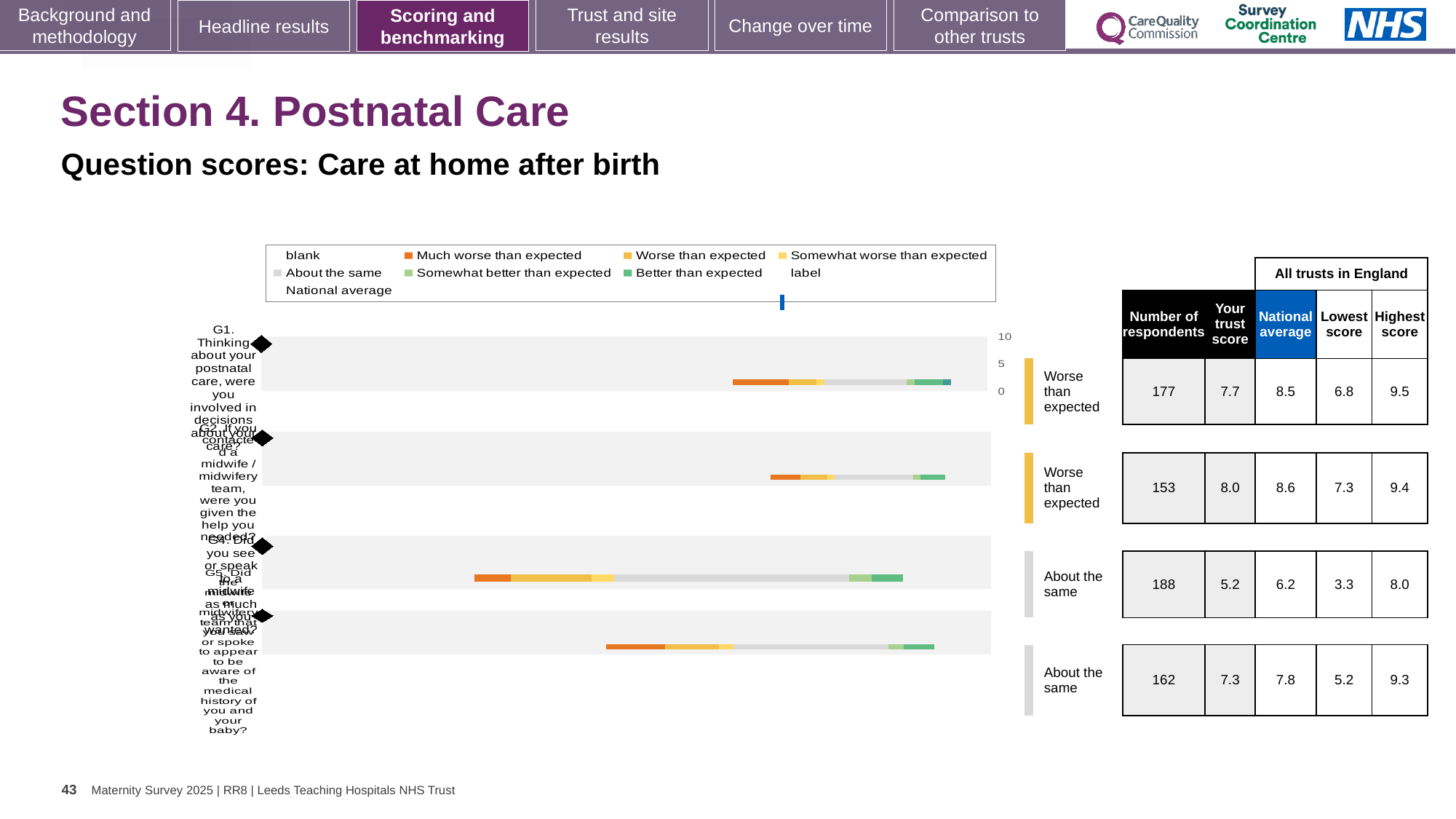
In the table beside the chart, which row has the highest number of respondents? the third row (188) How many question bars are plotted in the chart? 4 What rating label is shown next to the first (top) bar of the chart? Worse than expected Which legend entry is shown in orange in the chart? Much worse than expected In the table beside the chart, what is the difference between the national average and the trust score for the first row? 0.8 In the table beside the chart, what is the number of respondents for the first (top) row? 177 In the table beside the chart, is the trust score for the fourth row larger or smaller than its national average? smaller What kind of chart is shown on the slide? bar chart What rating label is shown next to the third bar of the chart? About the same How many entries does the chart legend list? 9 In the table beside the chart, which row has the lowest trust score? the third row (5.2) In the table beside the chart, what is the trust score for the third row? 5.2